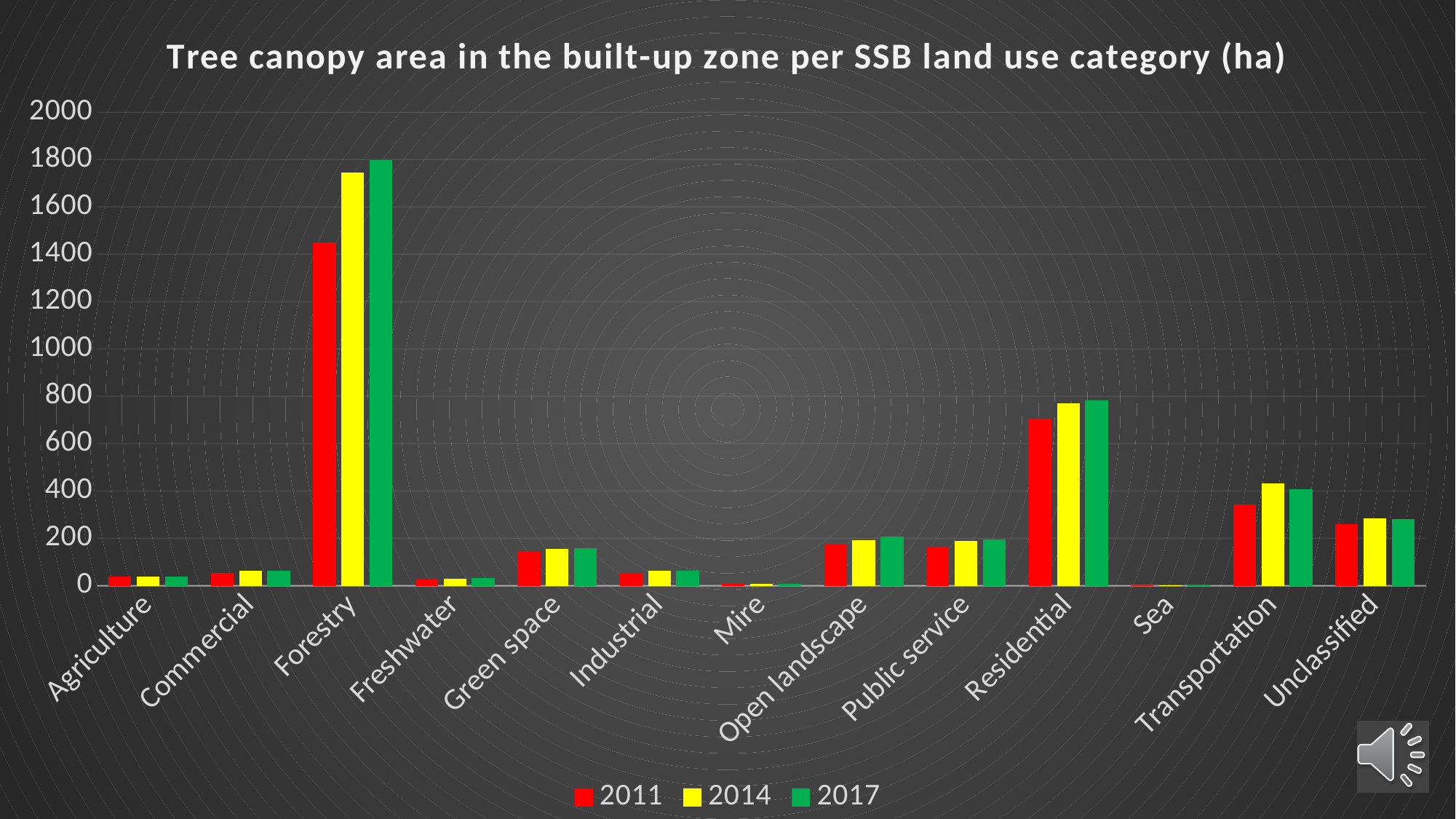
What kind of chart is shown on the slide? bar chart Is the 2011 value for Forestry greater or less than 1200? greater Which is larger in 2017, the value for Residential or the value for Transportation? Residential What colour represents the 2014 series in the legend? yellow Is the 2011 value for Green space greater or less than 200? less Is the 2014 value for Forestry greater or less than 1600? greater Do the Forestry values rise or fall from 2011 to 2017? rise How many land use categories are shown on the x axis? 13 Which land use category has the highest tree canopy area? Forestry How many series does the legend list? 3